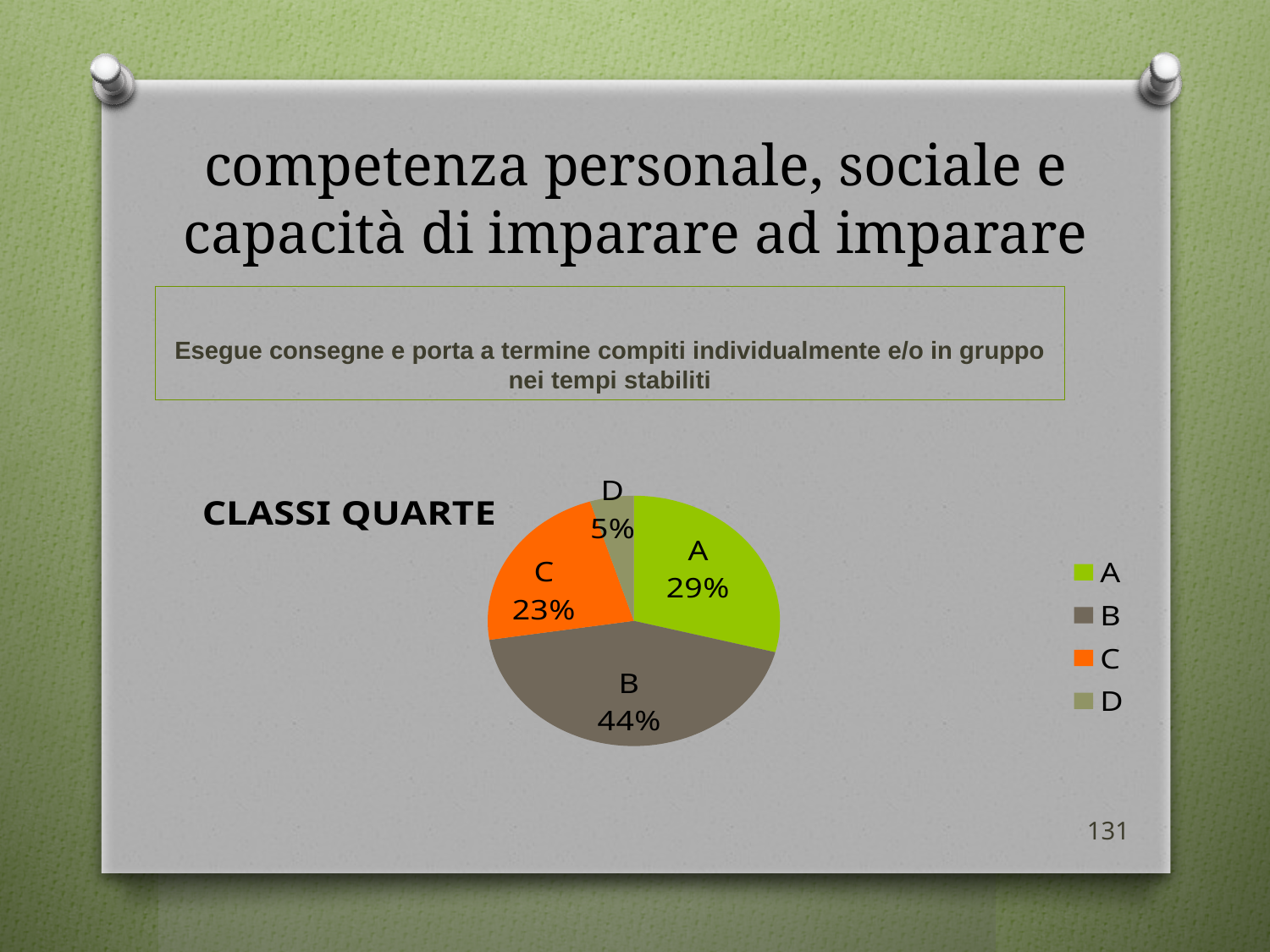
Which slice is the largest in the pie chart? B What share of the pie does slice D have? 5% What kind of chart is shown on the slide? pie chart What share of the pie does slice B have? 44% How many entries does the legend list? 4 What is the difference in percentage points between slice B and slice A? 15% What share of the pie does slice A have? 29% What label appears to the left of the pie chart? CLASSI QUARTE How many slices does the pie chart have? 4 Which is larger, slice A or slice C? A Which slice is the smallest in the pie chart? D